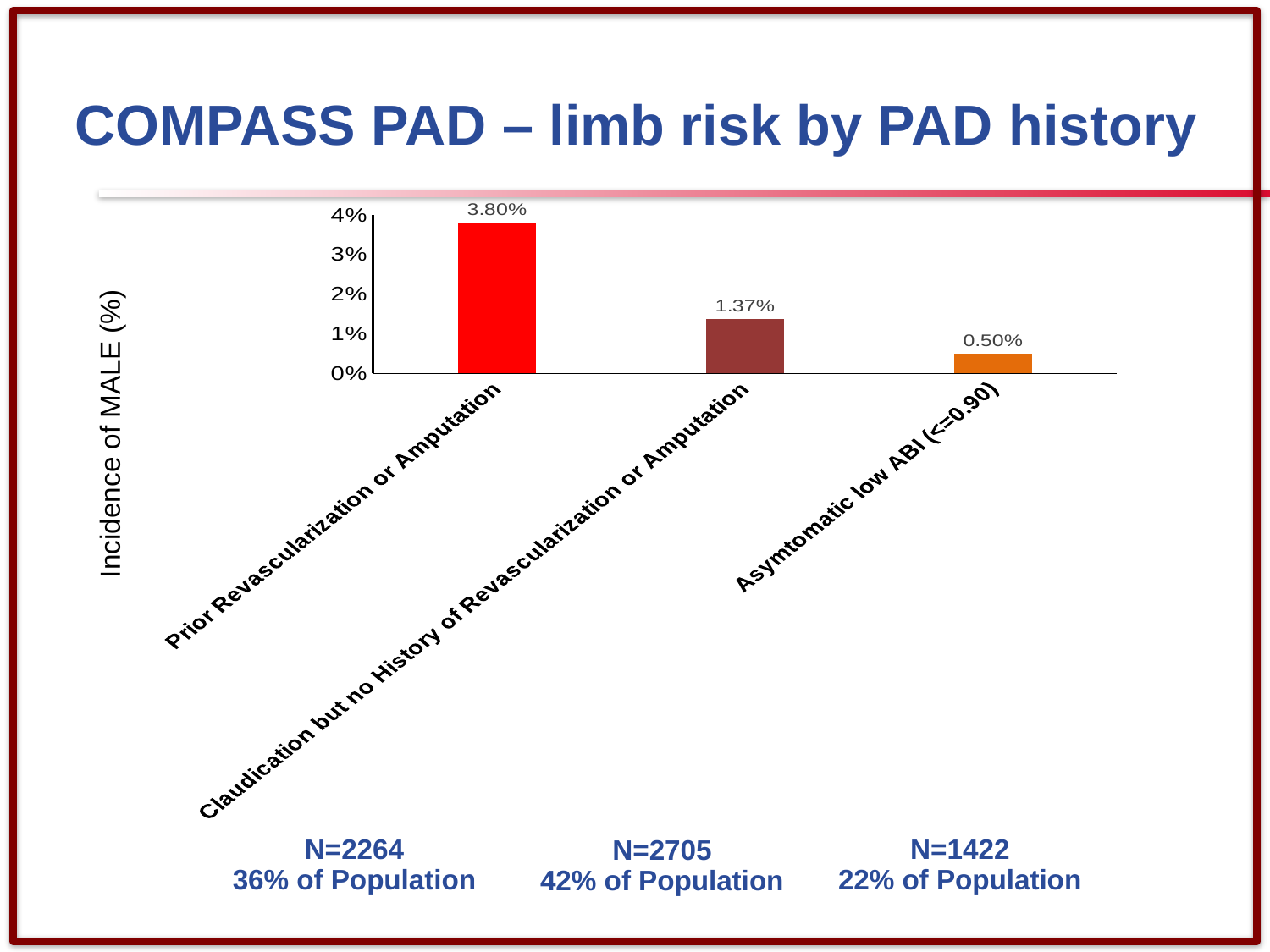
What is the incidence of MALE for the Prior Revascularization or Amputation group? 3.80% What is the difference in incidence of MALE between the Prior Revascularization or Amputation group and the Claudication but no History of Revascularization or Amputation group? 2.43% How many PAD history groups are shown in the chart? 3 What is the difference in incidence of MALE between the Claudication but no History of Revascularization or Amputation group and the Asymtomatic low ABI (<=0.90) group? 0.87% Which PAD history group has the highest incidence of MALE? Prior Revascularization or Amputation What is the label of the y axis of the chart? Incidence of MALE (%) Which PAD history group has the lowest incidence of MALE? Asymtomatic low ABI (<=0.90) What type of chart is shown on the slide? Bar chart What is the incidence of MALE for the Claudication but no History of Revascularization or Amputation group? 1.37% Which group has a higher incidence of MALE: Claudication but no History of Revascularization or Amputation, or Asymtomatic low ABI (<=0.90)? Claudication but no History of Revascularization or Amputation Is the incidence of MALE for the Prior Revascularization or Amputation group greater or less than 3%? greater What is the incidence of MALE for the Asymtomatic low ABI (<=0.90) group? 0.50%